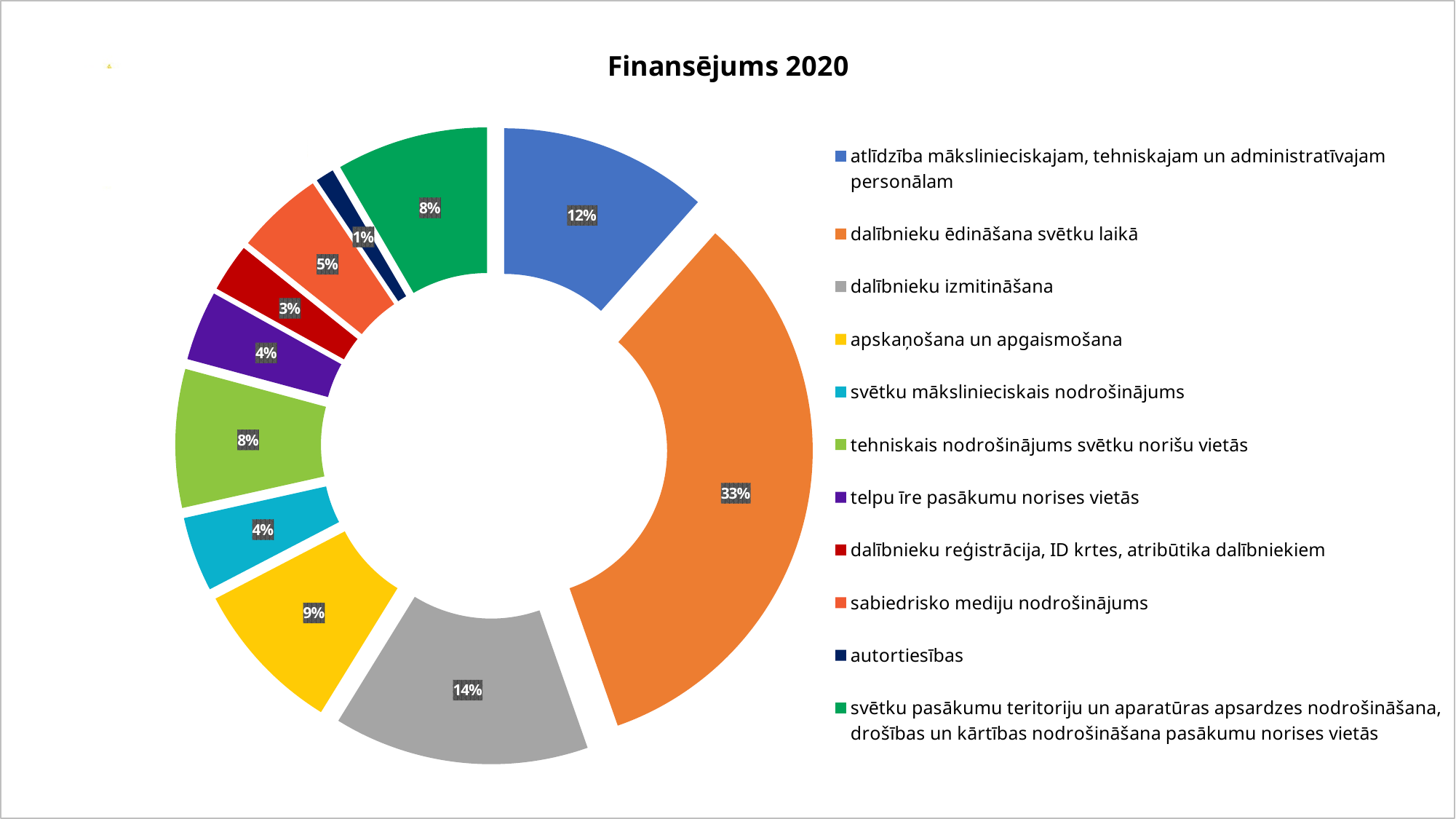
What is the title of the chart? Finansējums 2020 What percentage is shown for 'dalībnieku izmitināšana'? 14% What kind of chart is shown on the slide? doughnut (pie) chart Which category has the largest share of the chart? dalībnieku ēdināšana svētku laikā What share of the chart is 'dalībnieku ēdināšana svētku laikā'? 33% How many categories does the legend list? 11 What percentage is shown for 'apskaņošana un apgaismošana'? 9% What percentage is shown for 'autortiesības'? 1% Which category has the smallest share of the chart? autortiesības What is the difference in percentage points between 'dalībnieku ēdināšana svētku laikā' and 'dalībnieku izmitināšana'? 19 What percentage is shown for 'atlīdzība mākslinieciskajam, tehniskajam un administratīvajam personālam'? 12% Which is larger: 'sabiedrisko mediju nodrošinājums' or 'dalībnieku reģistrācija, ID krtes, atribūtika dalībniekiem'? sabiedrisko mediju nodrošinājums